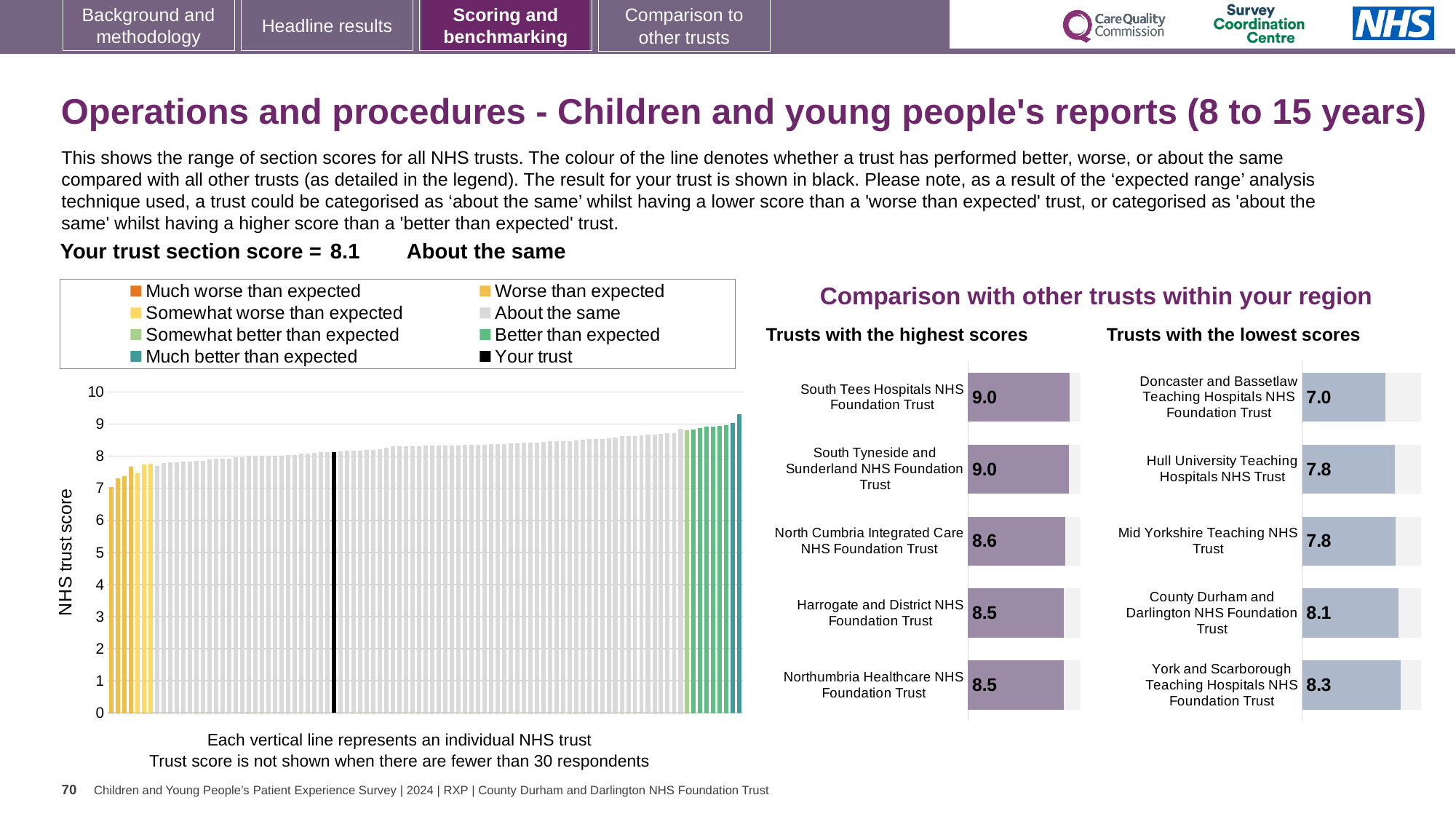
On the 'Trusts with the highest scores' chart, what is the difference between the scores of South Tees Hospitals NHS Foundation Trust and North Cumbria Integrated Care NHS Foundation Trust? 0.4 On the 'Trusts with the highest scores' chart, what is the score for South Tees Hospitals NHS Foundation Trust? 9.0 On the 'Trusts with the lowest scores' chart, which trust has the lowest score? Doncaster and Bassetlaw Teaching Hospitals NHS Foundation Trust How many entries does the legend of the main 'NHS trust score' chart list? 8 On the 'Trusts with the highest scores' chart, which has the higher score: South Tees Hospitals NHS Foundation Trust or Harrogate and District NHS Foundation Trust? South Tees Hospitals NHS Foundation Trust How many trusts are shown on the 'Trusts with the highest scores' chart? 5 On the 'Trusts with the lowest scores' chart, what is the score for Hull University Teaching Hospitals NHS Trust? 7.8 What kind of chart is the main 'NHS trust score' chart on the left of the slide? bar chart On the 'Trusts with the highest scores' chart, what is the score for North Cumbria Integrated Care NHS Foundation Trust? 8.6 On the 'Trusts with the lowest scores' chart, which trust has the highest score? York and Scarborough Teaching Hospitals NHS Foundation Trust On the 'Trusts with the lowest scores' chart, what is the difference between the scores of York and Scarborough Teaching Hospitals NHS Foundation Trust and Doncaster and Bassetlaw Teaching Hospitals NHS Foundation Trust? 1.3 On the main 'NHS trust score' chart on the left, what is the section score for your trust? 8.1